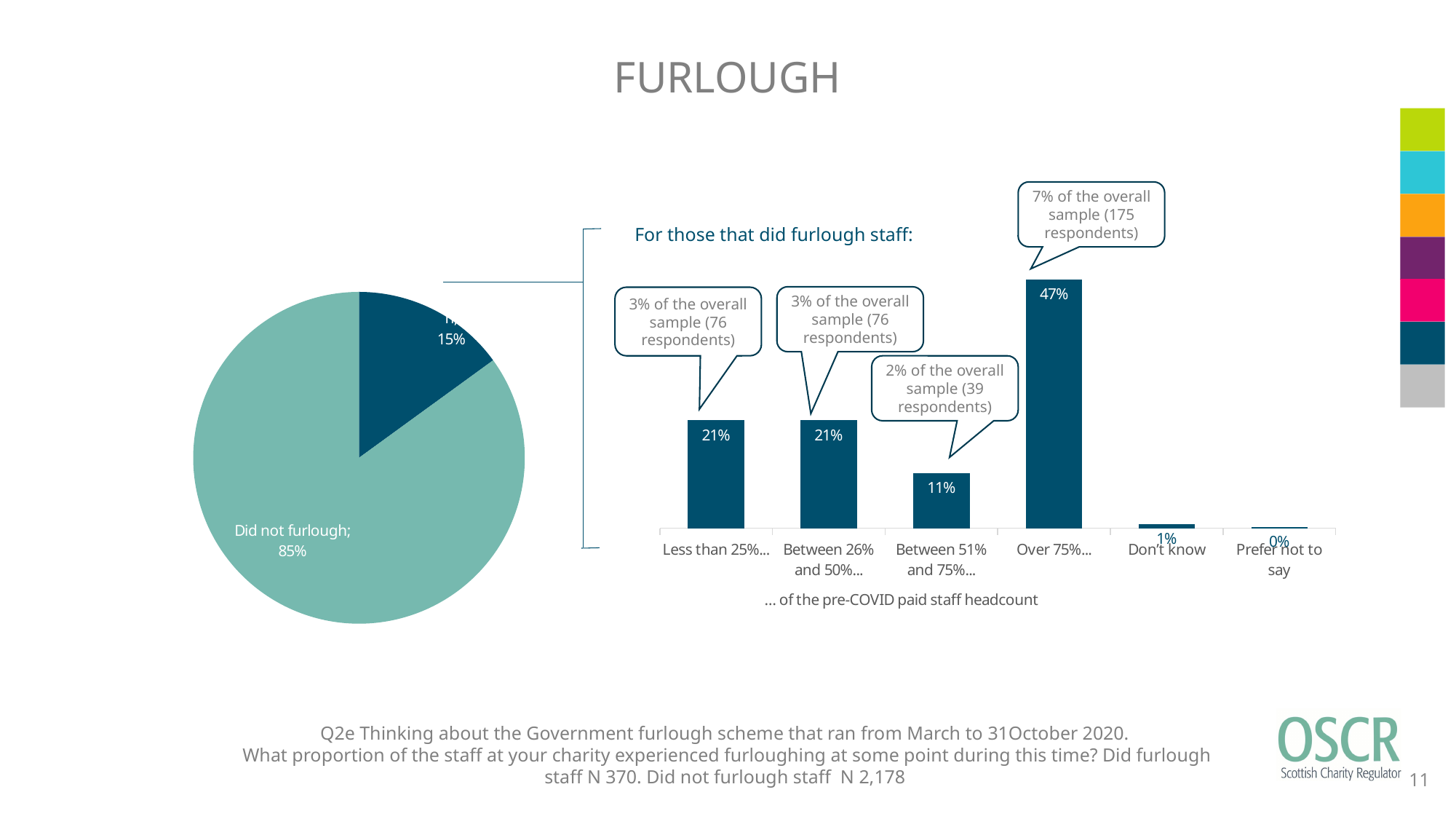
In the bar chart 'For those that did furlough staff:', how many categories are shown on the x axis? 6 What kind of chart is the chart on the right, titled 'For those that did furlough staff:'? Bar chart In the bar chart 'For those that did furlough staff:', which category has the highest value? Over 75%... In the bar chart 'For those that did furlough staff:', what is the value for 'Over 75%...'? 47% In the bar chart 'For those that did furlough staff:', which category has the lowest value? Prefer not to say In the bar chart 'For those that did furlough staff:', what is the value for 'Between 51% and 75%...'? 11% In the bar chart 'For those that did furlough staff:', what does the callout above the 'Over 75%...' bar say? 7% of the overall sample (175 respondents) In the bar chart 'For those that did furlough staff:', what is the value for 'Don't know'? 1% In the bar chart 'For those that did furlough staff:', what is the difference between the values for 'Over 75%...' and 'Less than 25%...'? 26% In the pie chart on the left, what percentage is shown for the smaller, dark blue slice? 15% What kind of chart is the chart on the left of the slide? Pie chart In the pie chart on the left, what share of respondents did not furlough staff? 85%